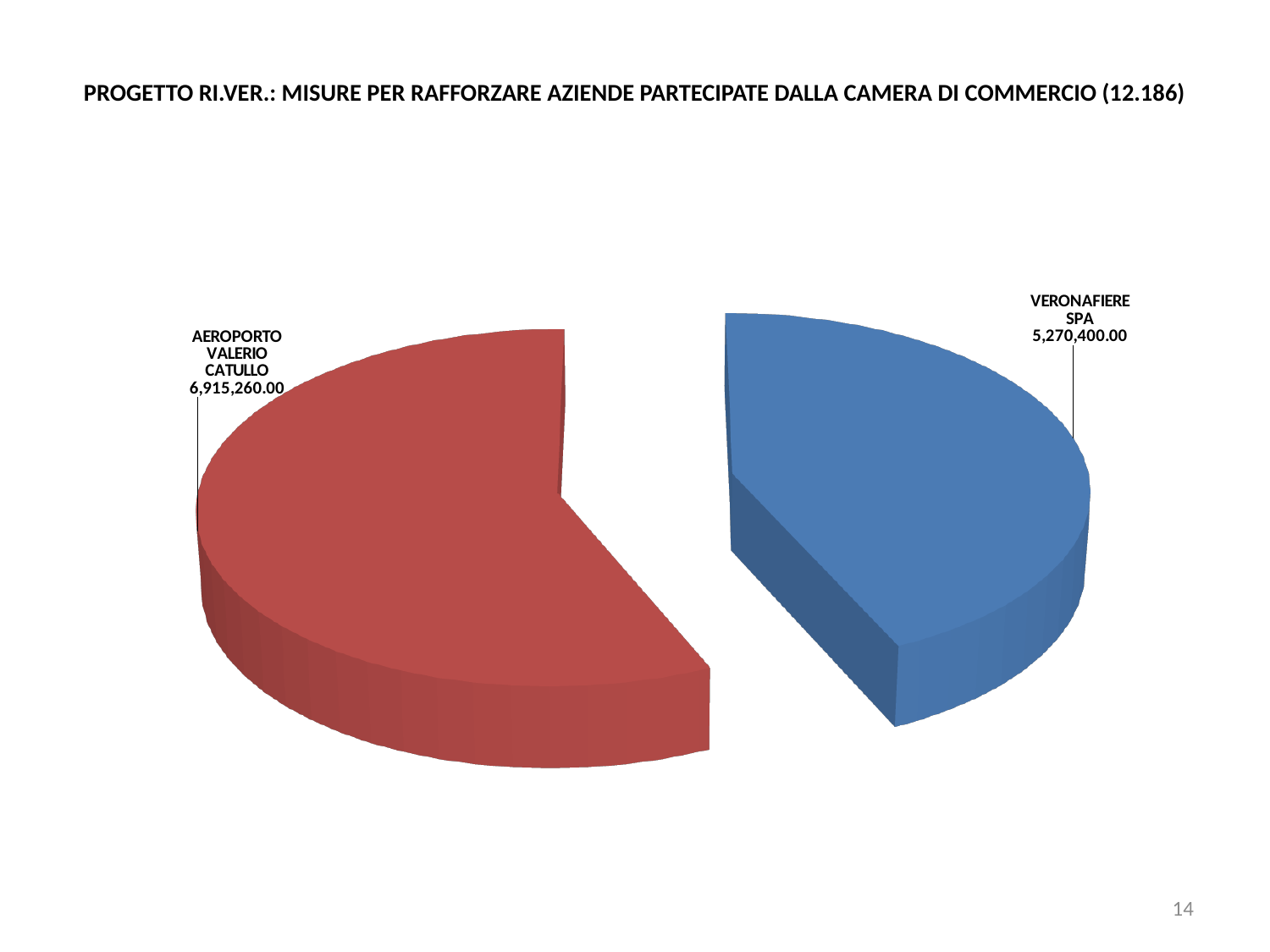
What share of the pie does AEROPORTO VALERIO CATULLO represent? 56.7% Which is larger, the value for AEROPORTO VALERIO CATULLO or the value for VERONAFIERE SPA? AEROPORTO VALERIO CATULLO What kind of chart is shown on the slide? Pie chart What share of the pie does VERONAFIERE SPA represent? 43.3% How many slices does the pie chart have? 2 What colour is the slice for VERONAFIERE SPA? Blue Which slice of the pie is the largest? AEROPORTO VALERIO CATULLO What is the value for AEROPORTO VALERIO CATULLO? 6,915,260.00 Which slice of the pie is the smallest? VERONAFIERE SPA What is the value for VERONAFIERE SPA? 5,270,400.00 What is the total of the two slices in the pie chart? 12,185,660.00 What is the difference between the value for AEROPORTO VALERIO CATULLO and the value for VERONAFIERE SPA? 1,644,860.00